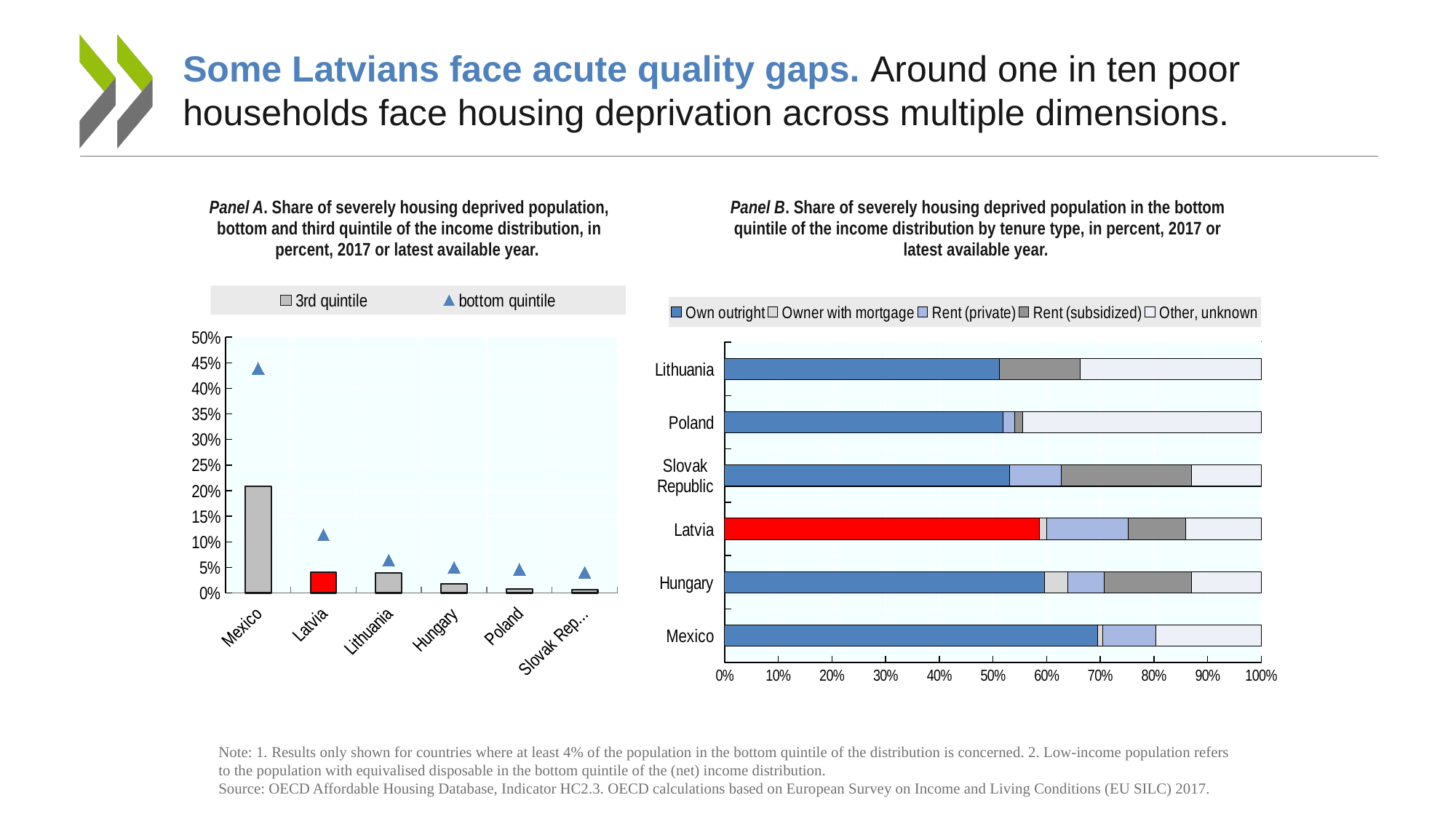
In Panel B, which country has the largest Own outright share? Mexico In Panel A, which has the larger 3rd quintile value, Mexico or Latvia? Mexico In Panel B, which country's Own outright segment is highlighted in red? Latvia In Panel A, is the bottom quintile value for Latvia greater or less than 20%? less In Panel B, how many series does the legend list? 5 In Panel A, is the bottom quintile value for Mexico greater or less than 40%? greater In Panel A, which country has the highest bottom quintile value? Mexico In Panel A, how many countries are shown on the x axis? 6 In Panel A, which country has the highest 3rd quintile value? Mexico What kind of chart is Panel B? Stacked bar chart In Panel A, do the bottom quintile values rise or fall moving from Mexico to Slovak Republic along the x axis? fall In Panel B, is the Own outright share for Mexico greater or less than 60%? greater